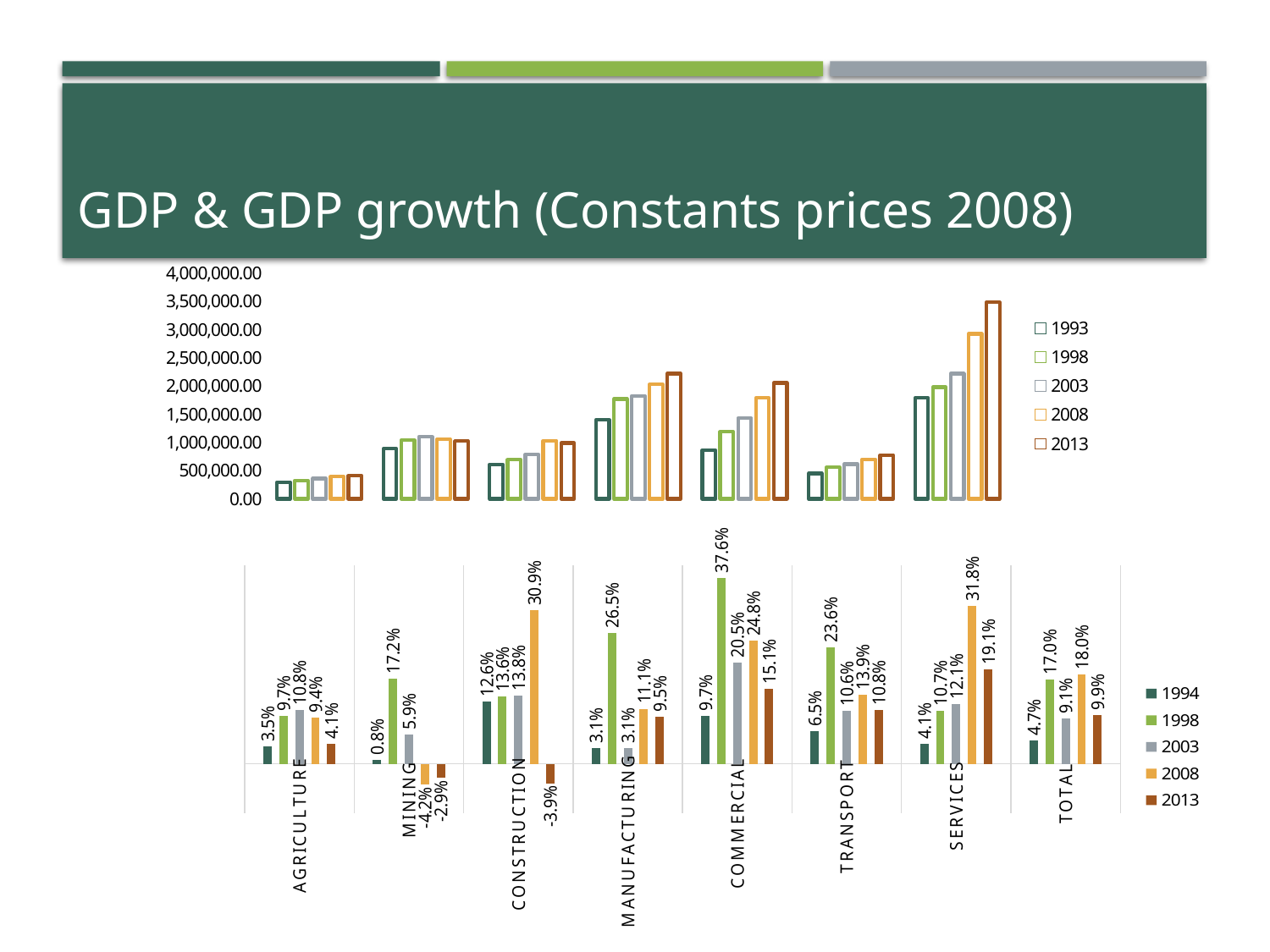
How many series does the legend of the top chart list? 5 In the bottom chart, what is the 2008 value for Construction? 30.9% How many categories are shown on the x axis of the bottom chart? 8 How many series does the legend of the bottom chart list? 5 In the bottom chart, which category has the lowest 2013 value? Construction In the bottom chart, what is the 2013 value for Services? 19.1% In the bottom chart, which category has the highest 1998 value? Commercial What is the title of the slide? GDP & GDP growth (Constants prices 2008) In the bottom chart, what is the difference between the 2008 and 1994 values for Total? 13.3% What kind of chart is the top chart? Bar chart In the bottom chart, what is the 1994 value for Mining? 0.8% In the bottom chart, which is larger for Transport: the 1998 value or the 2008 value? 1998